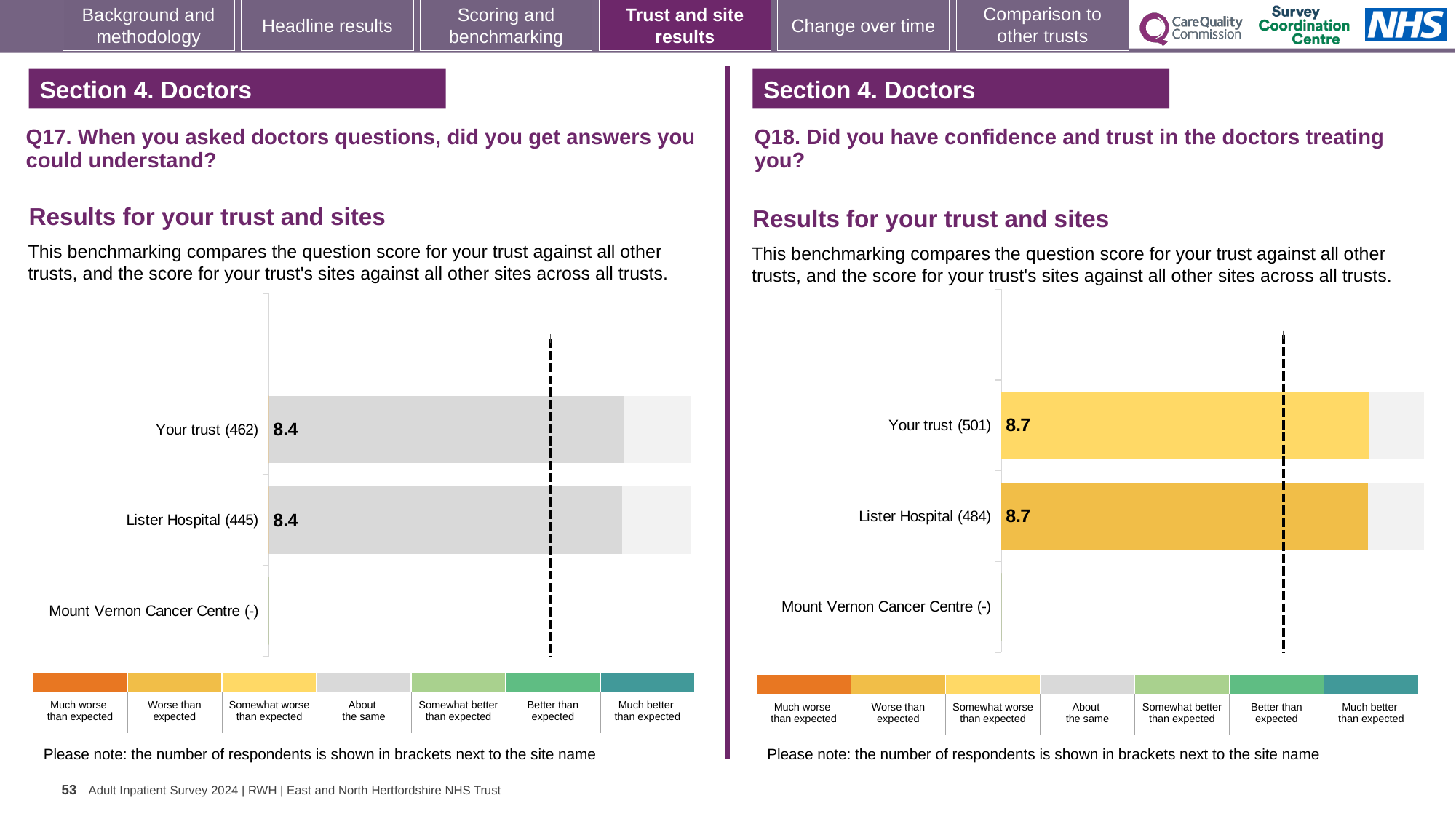
On the Q18 chart (right), how many site/trust categories are listed on the vertical axis? 3 On the Q18 chart (right), what is the difference between the scores for Your trust (501) and Lister Hospital (484)? 0.0 On the Q17 chart (left), how many site/trust categories are listed on the vertical axis? 3 On the Q18 chart (right), how many benchmark categories does the colour legend below the chart list? 7 On the Q17 chart (left), what is the score for Lister Hospital (445)? 8.4 On the Q18 chart (right), what is the score for Lister Hospital (484)? 8.7 On the Q17 chart (left), which benchmark category does the grey colour of the bars correspond to in the legend? About the same On the Q18 chart (right), which category has no score shown? Mount Vernon Cancer Centre (-) What kind of chart is used on the Q17 chart (left)? Bar chart On the Q18 chart (right), what is the score for Your trust (501)? 8.7 On the Q17 chart (left), what is the difference between the scores for Your trust (462) and Lister Hospital (445)? 0.0 On the Q17 chart (left), what is the score for Your trust (462)? 8.4